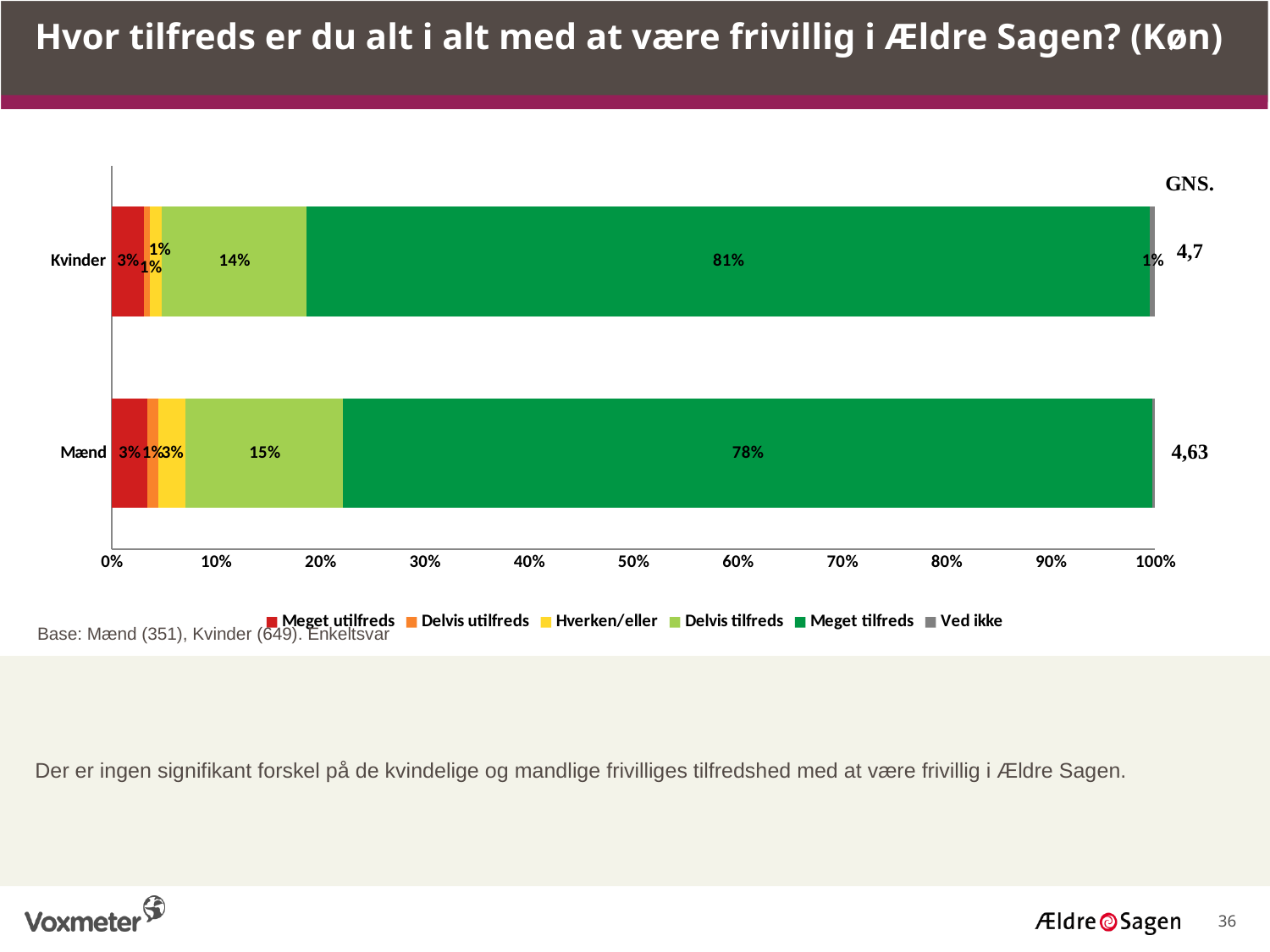
What is the difference in the Meget tilfreds share between Kvinder and Mænd? 3% Which group has the larger Meget tilfreds share, Kvinder or Mænd? Kvinder What is the GNS. (average) value shown for Mænd? 4,63 What percentage of Mænd answered Delvis tilfreds? 15% What kind of chart is shown on the slide? Stacked bar chart What percentage of Mænd answered Meget tilfreds? 78% What percentage of Kvinder answered Delvis tilfreds? 14% How many series does the legend list? 6 How many categories (groups) are shown on the chart? 2 What percentage of Kvinder answered Meget tilfreds? 81% What percentage of Mænd answered Hverken/eller? 3% What is the GNS. (average) value shown for Kvinder? 4,7